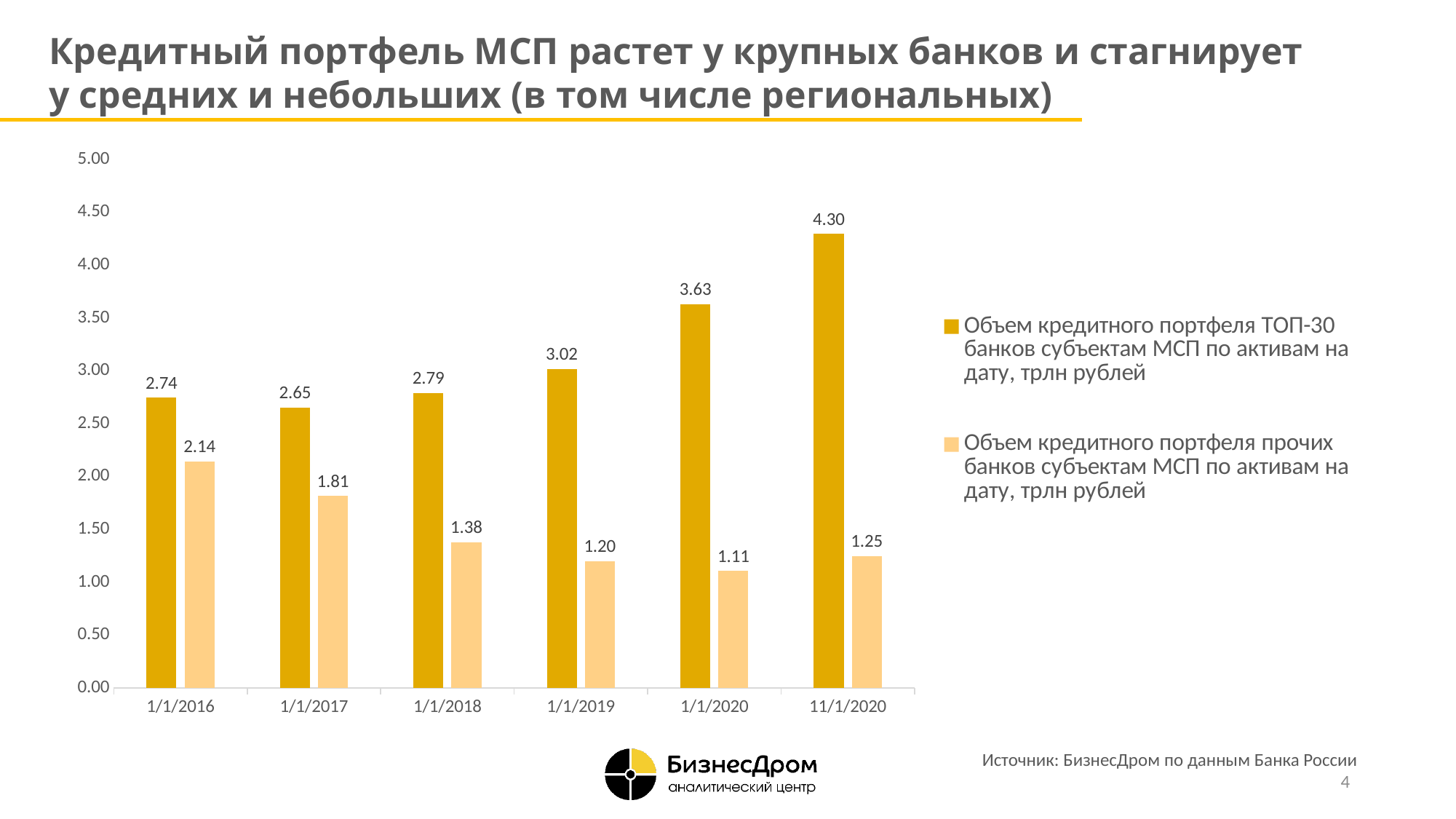
What is the value of the TOP-30 banks' SME loan portfolio (Объем кредитного портфеля ТОП-30 банков) on 11/1/2020? 4.30 What is the value of the other banks' SME loan portfolio on 1/1/2020? 1.11 On which date is the other banks' SME loan portfolio the lowest? 1/1/2020 How many dates are shown on the x axis of the chart? 6 Does the other banks' SME loan portfolio generally rise or fall from 1/1/2016 to 1/1/2020? Fall On which date is the TOP-30 banks' SME loan portfolio the highest? 11/1/2020 What is the value of the other banks' SME loan portfolio (Объем кредитного портфеля прочих банков) on 1/1/2016? 2.14 What type of chart is shown on the slide? Bar chart Which is larger on 1/1/2017: the TOP-30 banks' portfolio or the other banks' portfolio? TOP-30 banks' portfolio (2.65) What is the difference between the TOP-30 banks' and the other banks' SME loan portfolios on 11/1/2020? 3.05 How many series does the legend list? 2 What is the value of the TOP-30 banks' SME loan portfolio on 1/1/2019? 3.02